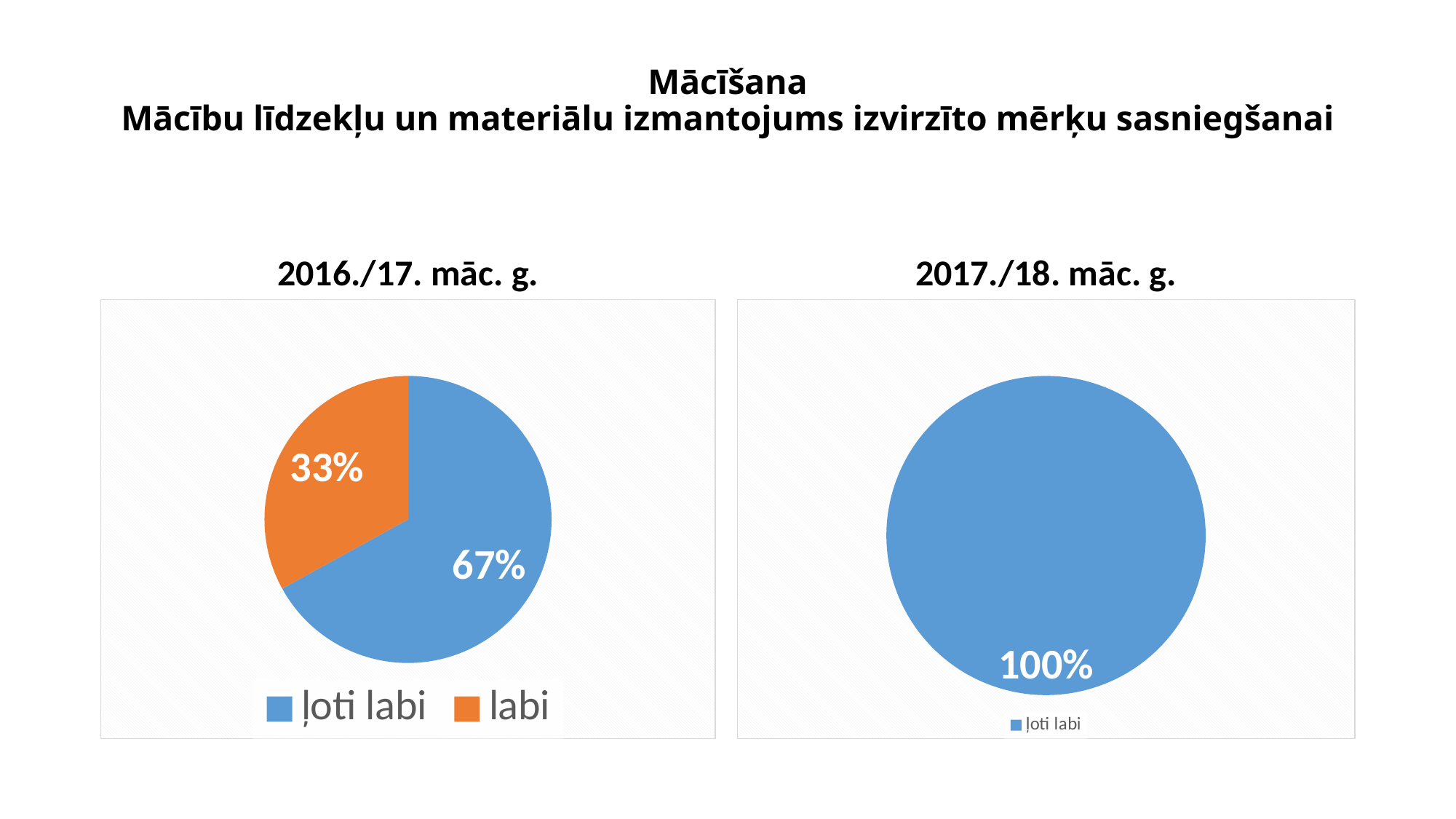
How many slices does the 2017./18. māc. g. chart have? 1 In the 2016./17. māc. g. chart, which category has the smallest slice? labi In the 2017./18. māc. g. chart, what share does the 'ļoti labi' slice have? 100% What kind of chart is the 2017./18. māc. g. chart? Pie chart How many entries does the legend of the 2016./17. māc. g. chart list? 2 In the 2016./17. māc. g. chart, what colour is the 'labi' slice? Orange In the 2016./17. māc. g. chart, which is larger, 'ļoti labi' or 'labi'? ļoti labi In the 2016./17. māc. g. chart, what share does the 'labi' slice have? 33% In the 2016./17. māc. g. chart, which category has the largest slice? ļoti labi How many slices does the 2016./17. māc. g. chart have? 2 In the 2016./17. māc. g. chart, what is the difference between the 'ļoti labi' and 'labi' shares? 34% In the 2016./17. māc. g. chart, what share does the 'ļoti labi' slice have? 67%